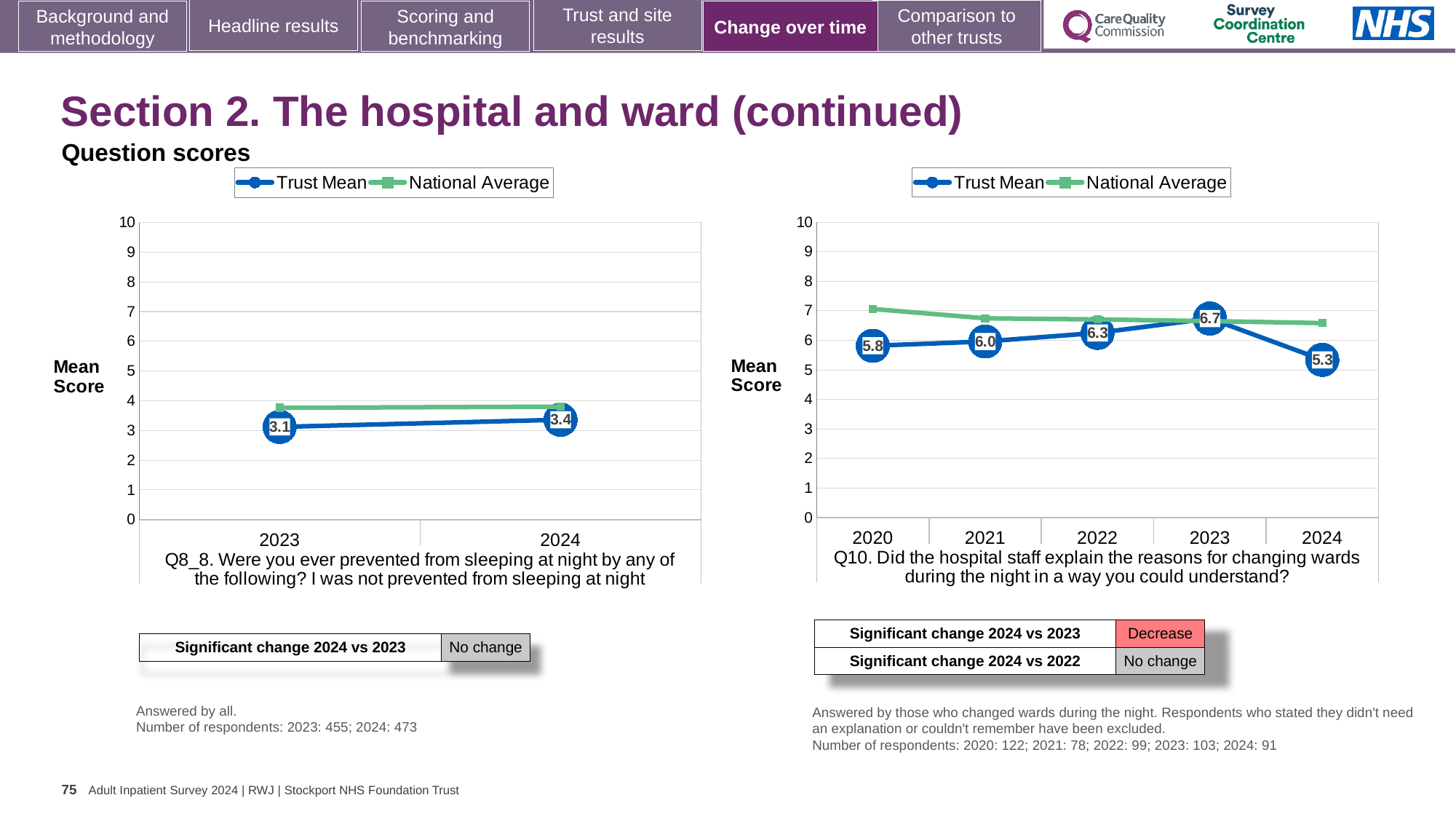
In the Q10 chart on the right, what is the Trust Mean score for 2022? 6.3 In the Q8_8 chart on the left, is the National Average for 2023 greater or less than 3? greater In the Q10 chart on the right, how many years are plotted on the x axis? 5 In the Q10 chart on the right, which year has the lowest Trust Mean score? 2024 In the Q8_8 chart on the left, what is the Trust Mean score for 2024? 3.4 In the Q10 chart on the right, what is the difference between the Trust Mean for 2023 and 2024? 1.4 How many series does the legend of the Q10 chart on the right list? 2 In the Q10 chart on the right, which year has the highest Trust Mean score? 2023 In the Q8_8 chart on the left, by how much did the Trust Mean change from 2023 to 2024? 0.3 What kind of chart is the Q8_8 chart on the left? Line chart In the Q10 chart on the right, is the Trust Mean for 2020 or 2021 higher? 2021 In the Q8_8 chart on the left, what is the Trust Mean score for 2023? 3.1